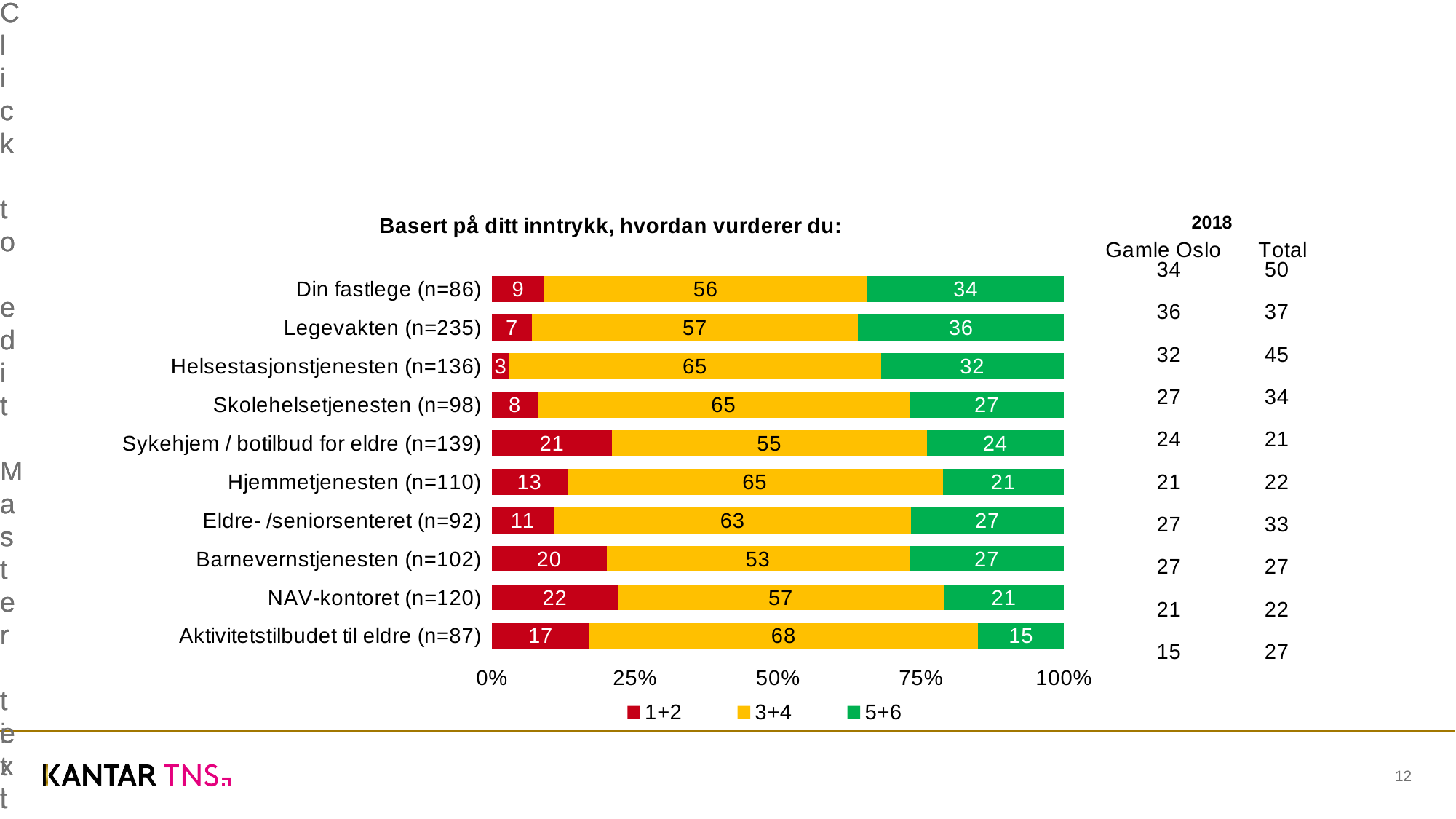
What is the title of the chart? Basert på ditt inntrykk, hvordan vurderer du: Which is larger: the 5+6 value for Sykehjem / botilbud for eldre (n=139) or for Hjemmetjenesten (n=110)? Sykehjem / botilbud for eldre (n=139) What is the value of the 5+6 series for Din fastlege (n=86)? 34 Which category has the lowest value in the 5+6 series? Aktivitetstilbudet til eldre (n=87) What kind of chart is shown on the slide? Stacked bar chart How many series does the legend list? 3 What is the value of the 1+2 series for NAV-kontoret (n=120)? 22 How many categories are shown in the chart? 10 What is the difference between the 1+2 values for NAV-kontoret (n=120) and Din fastlege (n=86)? 13 Which category has the lowest value in the 1+2 series? Helsestasjonstjenesten (n=136) What is the value of the 3+4 series for Aktivitetstilbudet til eldre (n=87)? 68 Which category has the highest value in the 5+6 series? Legevakten (n=235)